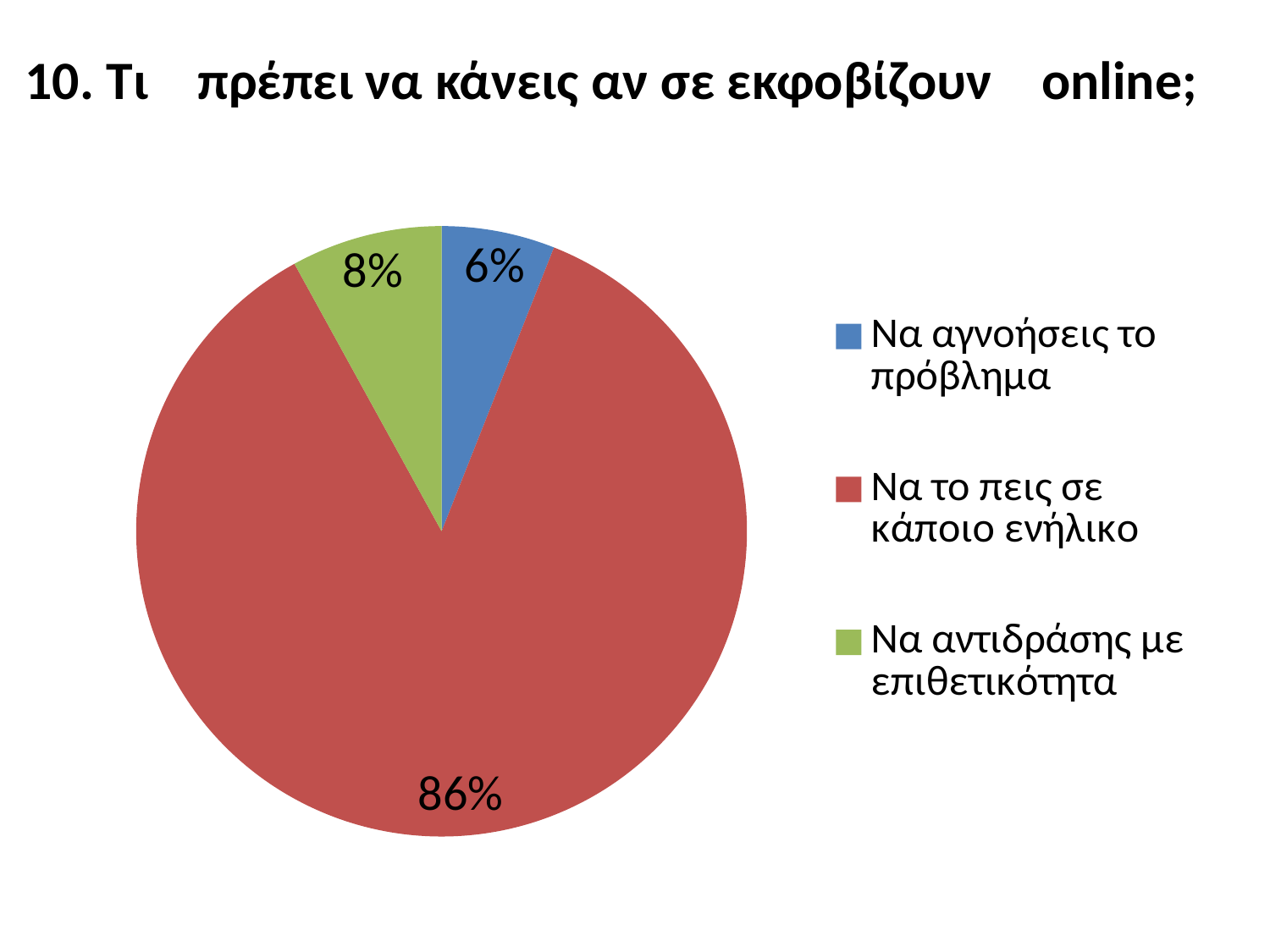
What share of the pie does "Να το πεις σε κάποιο ενήλικο" have? 86% Which is larger: the slice for "Να αντιδράσης με επιθετικότητα" or the slice for "Να αγνοήσεις το πρόβλημα"? Να αντιδράσης με επιθετικότητα What colour is the slice for "Να το πεις σε κάποιο ενήλικο"? red What is the title of the slide? 10. Τι πρέπει να κάνεις αν σε εκφοβίζουν online; What share of the pie does "Να αντιδράσης με επιθετικότητα" have? 8% Which category has the smallest slice of the pie? Να αγνοήσεις το πρόβλημα What is the difference in percentage points between "Να το πεις σε κάποιο ενήλικο" and "Να αντιδράσης με επιθετικότητα"? 78 What share of the pie does "Να αγνοήσεις το πρόβλημα" have? 6% Which category has the largest slice of the pie? Να το πεις σε κάποιο ενήλικο How many categories does the pie chart have? 3 What is the difference in percentage points between "Να αντιδράσης με επιθετικότητα" and "Να αγνοήσεις το πρόβλημα"? 2 What kind of chart is shown on the slide? pie chart